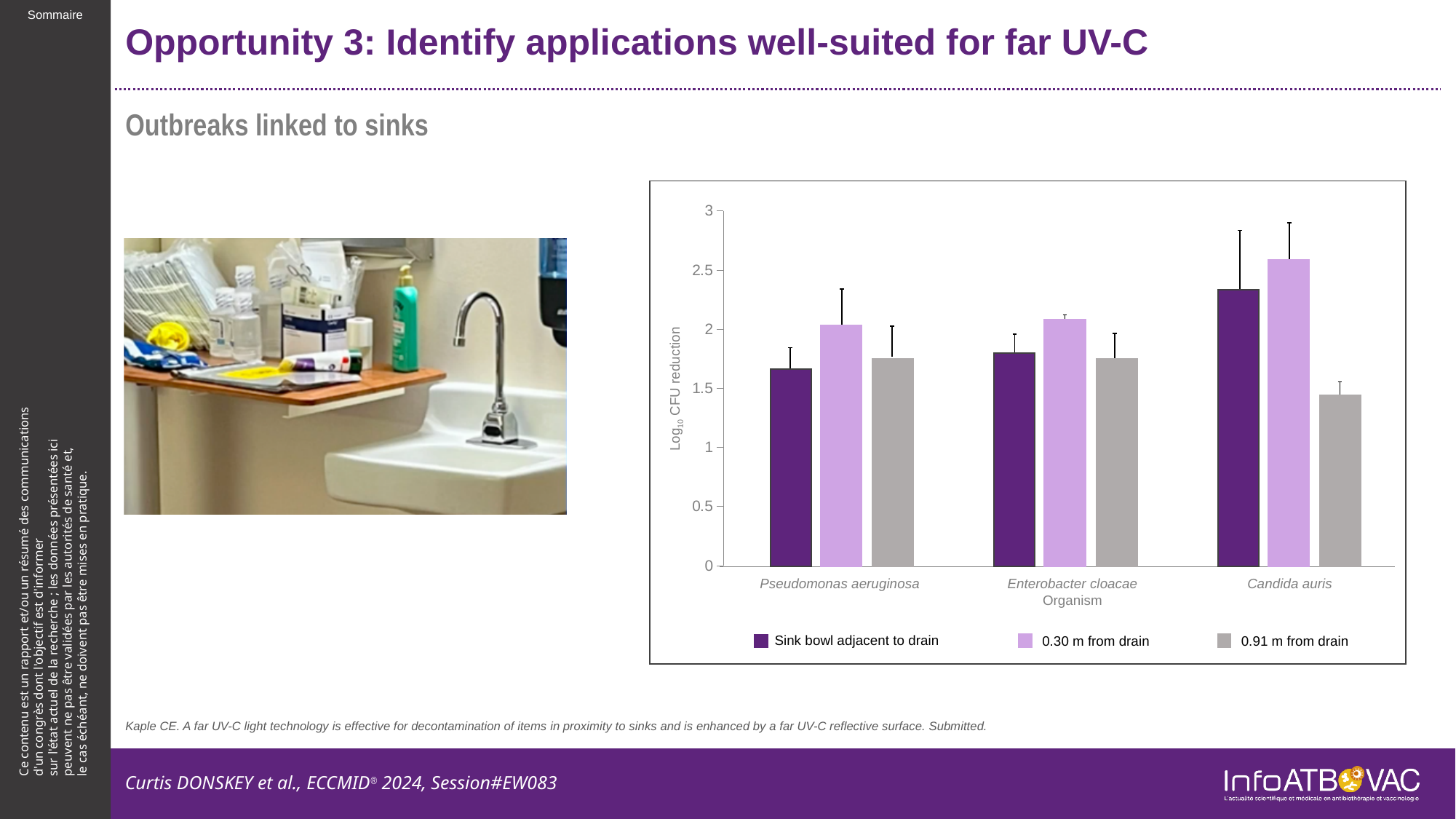
For Enterobacter cloacae, which is larger: the '0.30 m from drain' bar or the '0.91 m from drain' bar? 0.30 m from drain What kind of chart is shown on the slide? bar chart For Candida auris, which is larger: the 'Sink bowl adjacent to drain' bar or the '0.91 m from drain' bar? Sink bowl adjacent to drain Is the value for Candida auris in the 'Sink bowl adjacent to drain' series greater or less than 2? greater How many series does the chart's legend list? 3 Is the value for Pseudomonas aeruginosa in the 'Sink bowl adjacent to drain' series greater or less than 2? less How many organisms are shown on the x axis of the chart? 3 Which series has the lowest bar for Candida auris? 0.91 m from drain Which series has the highest bar for Candida auris? 0.30 m from drain Is the value for Candida auris in the '0.91 m from drain' series greater or less than 2? less Which series has the highest bar for Pseudomonas aeruginosa? 0.30 m from drain What is the label of the chart's x axis? Organism